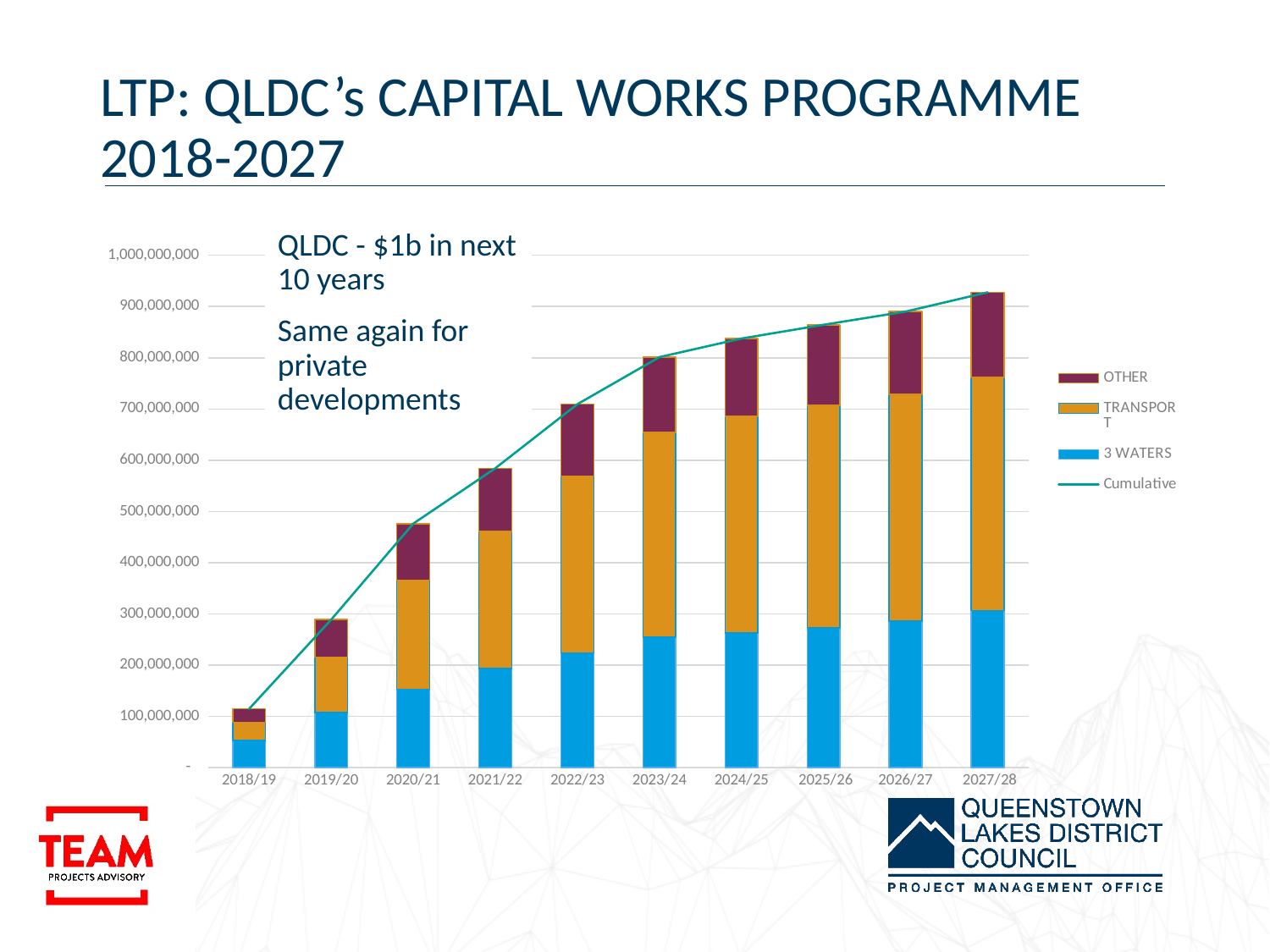
Is the 3 WATERS value for 2018/19 greater or less than 100,000,000? less Which year has the shortest stacked bar? 2018/19 What kind of chart is shown on the slide? Stacked bar chart with a cumulative line How many series does the chart legend list? 4 Do the stacked bar totals rise or fall from 2018/19 to 2027/28? Rise Which series is shown in blue at the bottom of each stacked bar? 3 WATERS Which year has the tallest stacked bar? 2027/28 Is the total stacked bar for 2027/28 greater or less than 900,000,000? greater Is the 3 WATERS value for 2023/24 greater or less than 200,000,000? greater Which stacked bar is taller, 2019/20 or 2025/26? 2025/26 How many categories (years) are shown on the x axis of the chart? 10